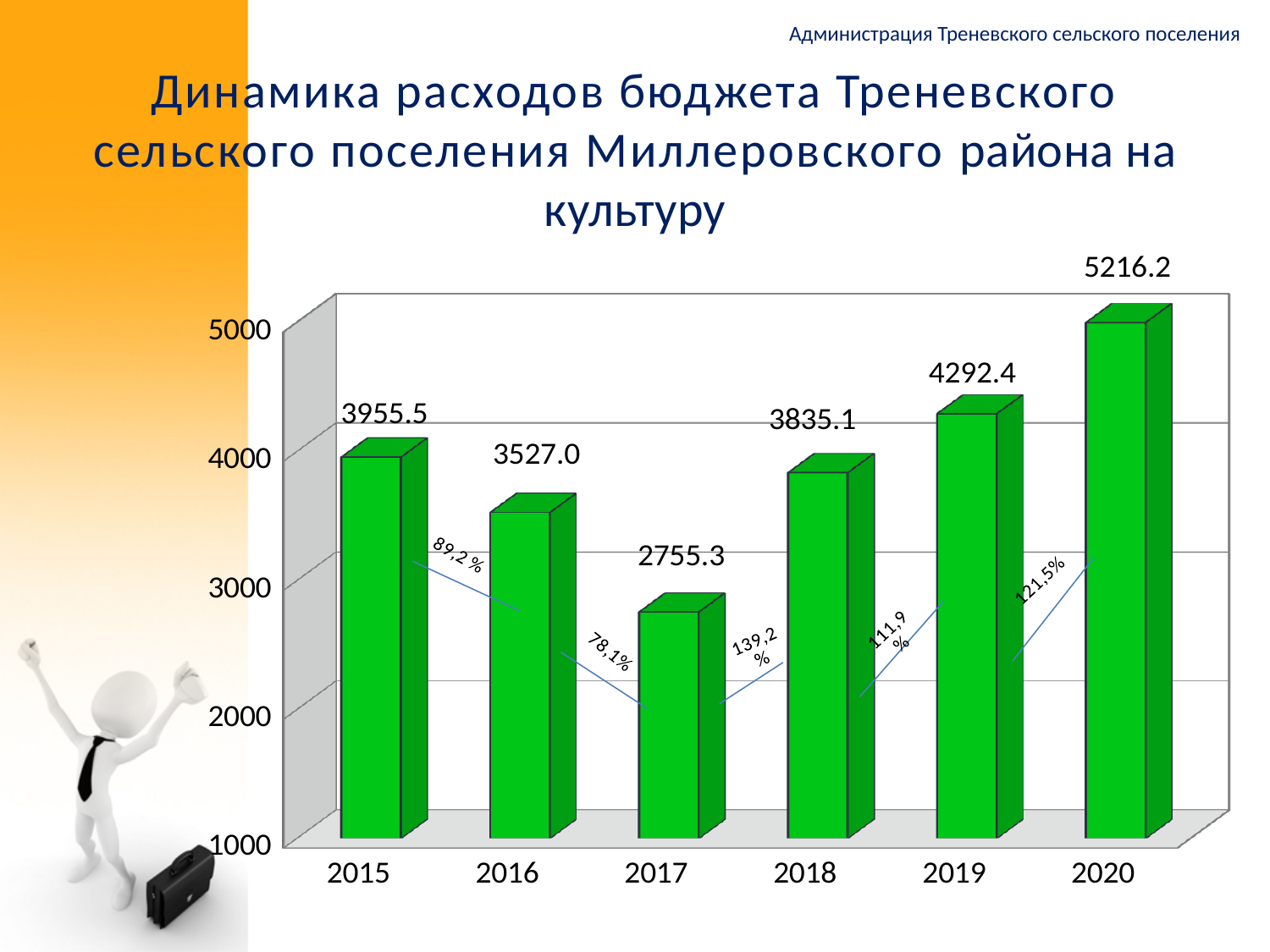
What is the difference between the values for 2020 and 2019? 923.8 What kind of chart is shown on the slide? bar chart What is the value for 2020? 5216.2 Which year has the highest value? 2020 How many years are shown on the x axis? 6 Is the value for 2019 greater or less than 4000? greater Which is larger, the value for 2018 or the value for 2016? 2018 Which year has the lowest value? 2017 What percentage is written on the line between the 2019 and 2020 bars? 121,5% What is the value for 2015? 3955.5 What is the value for 2017? 2755.3 What is the difference between the values for 2015 and 2016? 428.5